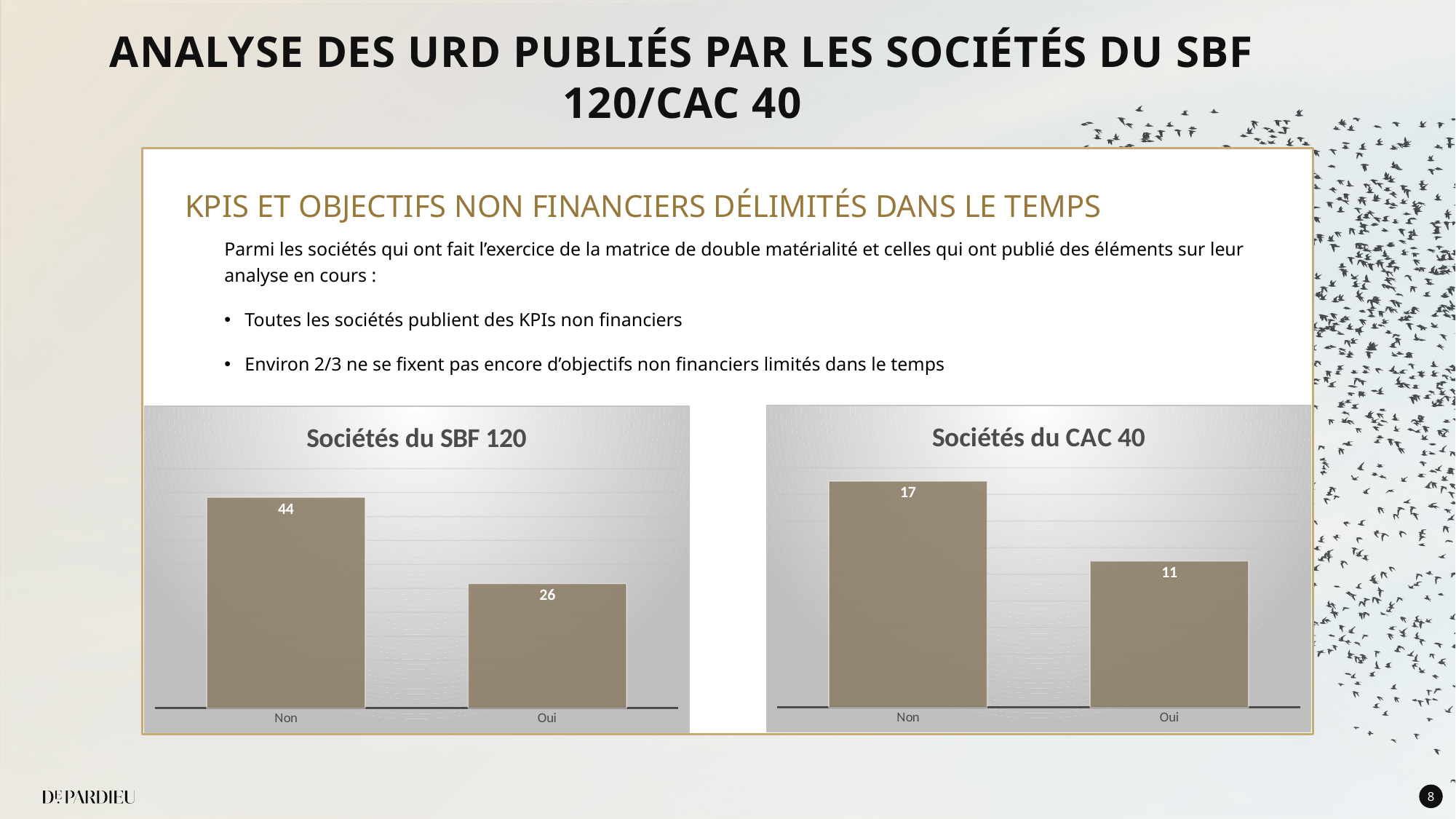
In the 'Sociétés du CAC 40' chart, which is larger, the value for Non or the value for Oui? Non What is the title of the chart on the left side of the slide? Sociétés du SBF 120 In the 'Sociétés du CAC 40' chart, what is the value for Non? 17 In the 'Sociétés du SBF 120' chart, what is the value for Non? 44 In the 'Sociétés du SBF 120' chart, what is the difference between the values for Non and Oui? 18 What kind of chart is the 'Sociétés du CAC 40' chart? Bar chart In the 'Sociétés du SBF 120' chart, what is the value for Oui? 26 In the 'Sociétés du CAC 40' chart, which category has the lowest value? Oui In the 'Sociétés du CAC 40' chart, what is the difference between the values for Non and Oui? 6 In the 'Sociétés du CAC 40' chart, what is the value for Oui? 11 In the 'Sociétés du SBF 120' chart, which category has the highest value? Non How many categories are shown in the 'Sociétés du SBF 120' chart? 2